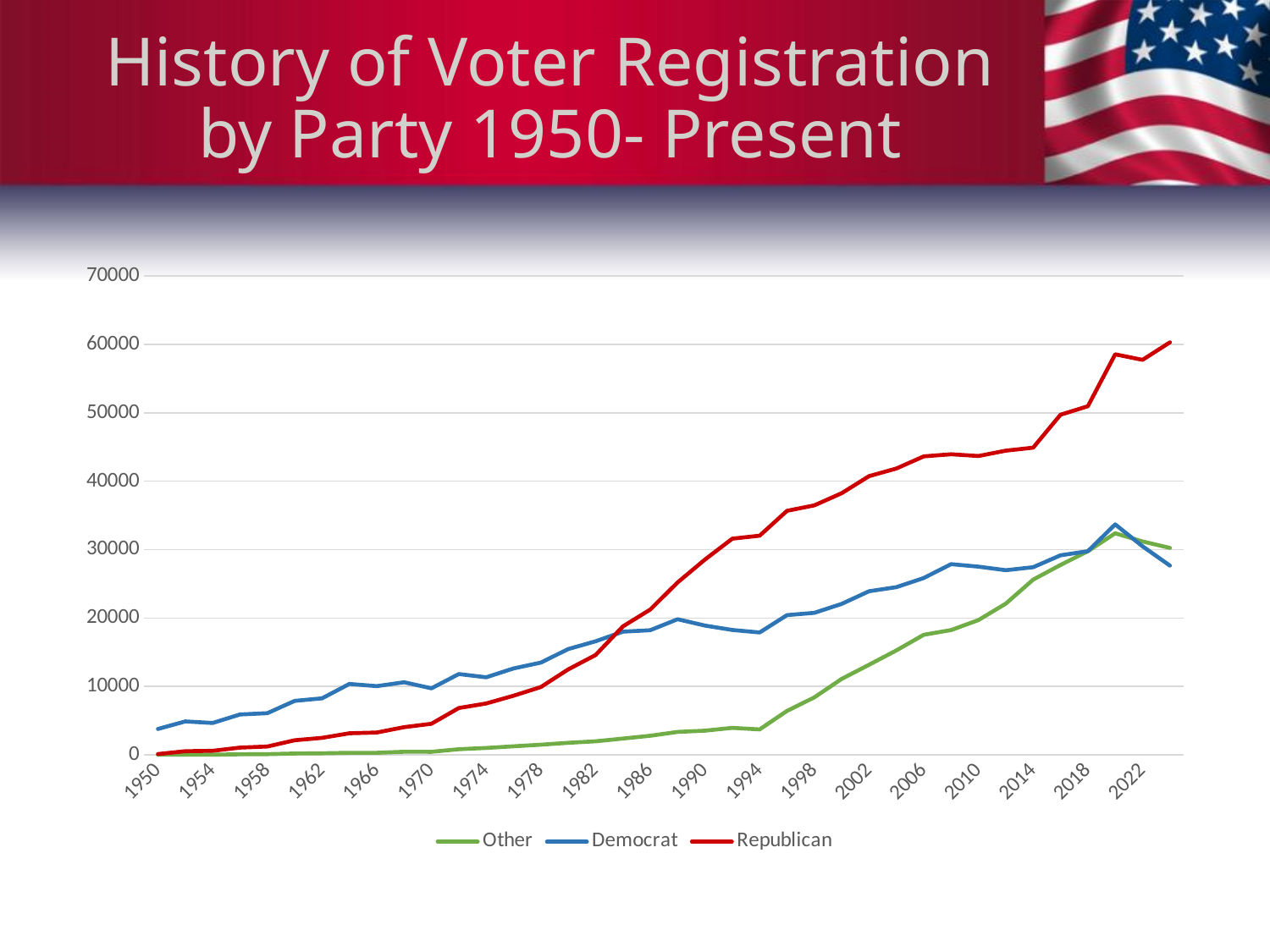
In 2022, which is larger, the Republican value or the Democrat value? Republican Is the Republican value for 2022 greater or less than 50000? greater Does the Republican series generally rise or fall from 1950 to 2022? rise What is the title of the slide containing the chart? History of Voter Registration by Party 1950- Present Is the Democrat value for 1950 greater or less than 10000? less Which series are listed in the legend? Other, Democrat, Republican Is the Other value for 2006 greater or less than 10000? greater How many series does the legend list? 3 Which series has the highest value in 2022? Republican In 1950, which is larger, the Democrat value or the Republican value? Democrat What kind of chart is shown on the slide? line chart Which series has the lowest value in 1950? Other